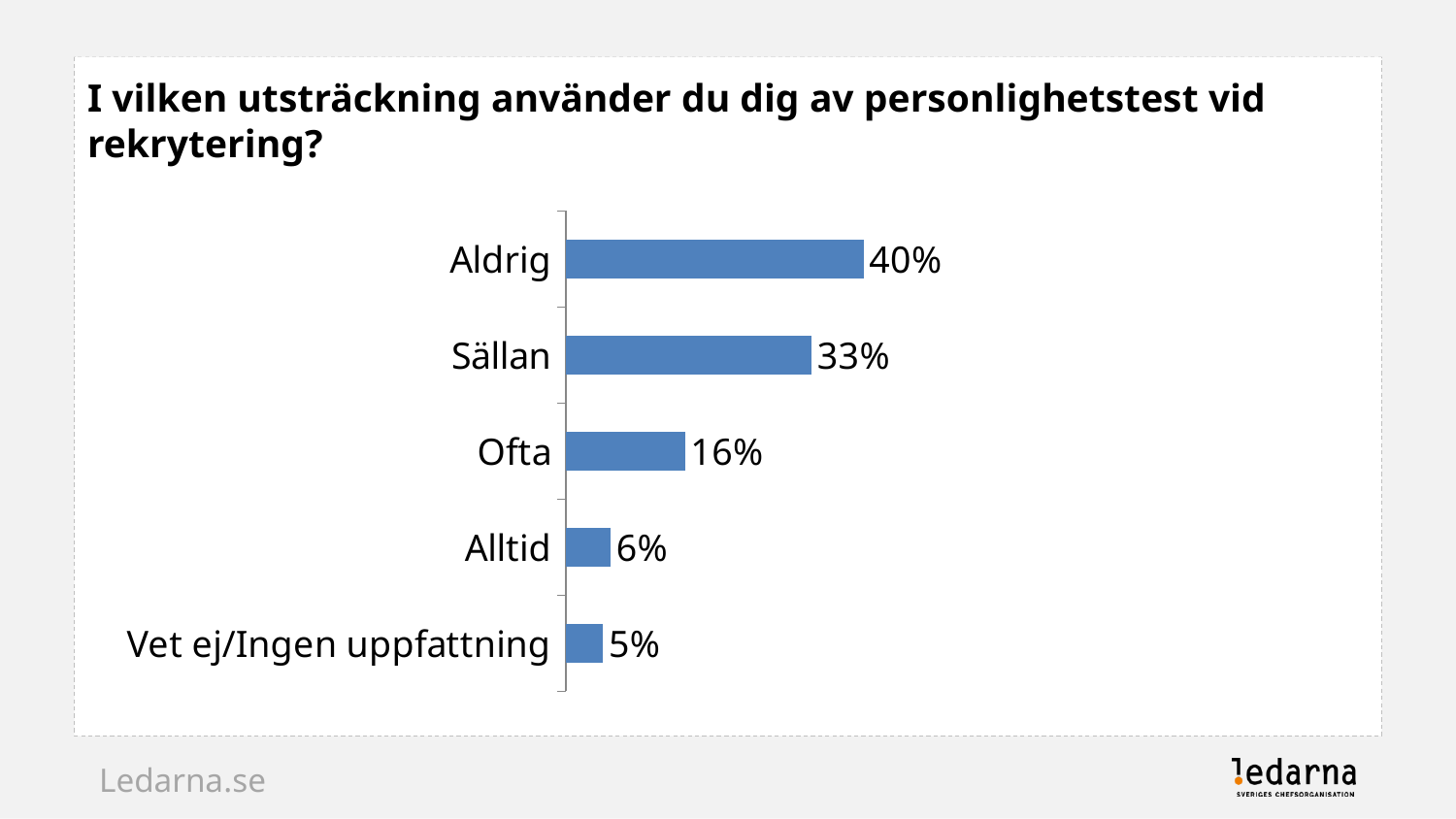
What kind of chart is shown on the slide? Bar chart What is the value for Sällan? 33% What is the difference between the values for Ofta and Alltid? 10% What is the value for Alltid? 6% What is the value for Vet ej/Ingen uppfattning? 5% What is the difference between the values for Aldrig and Sällan? 7% What is the value for Ofta? 16% Which category has the lowest value? Vet ej/Ingen uppfattning Which category has the highest value? Aldrig How many categories are shown in the chart? 5 Which is larger, the value for Sällan or the value for Ofta? Sällan What is the value for Aldrig? 40%